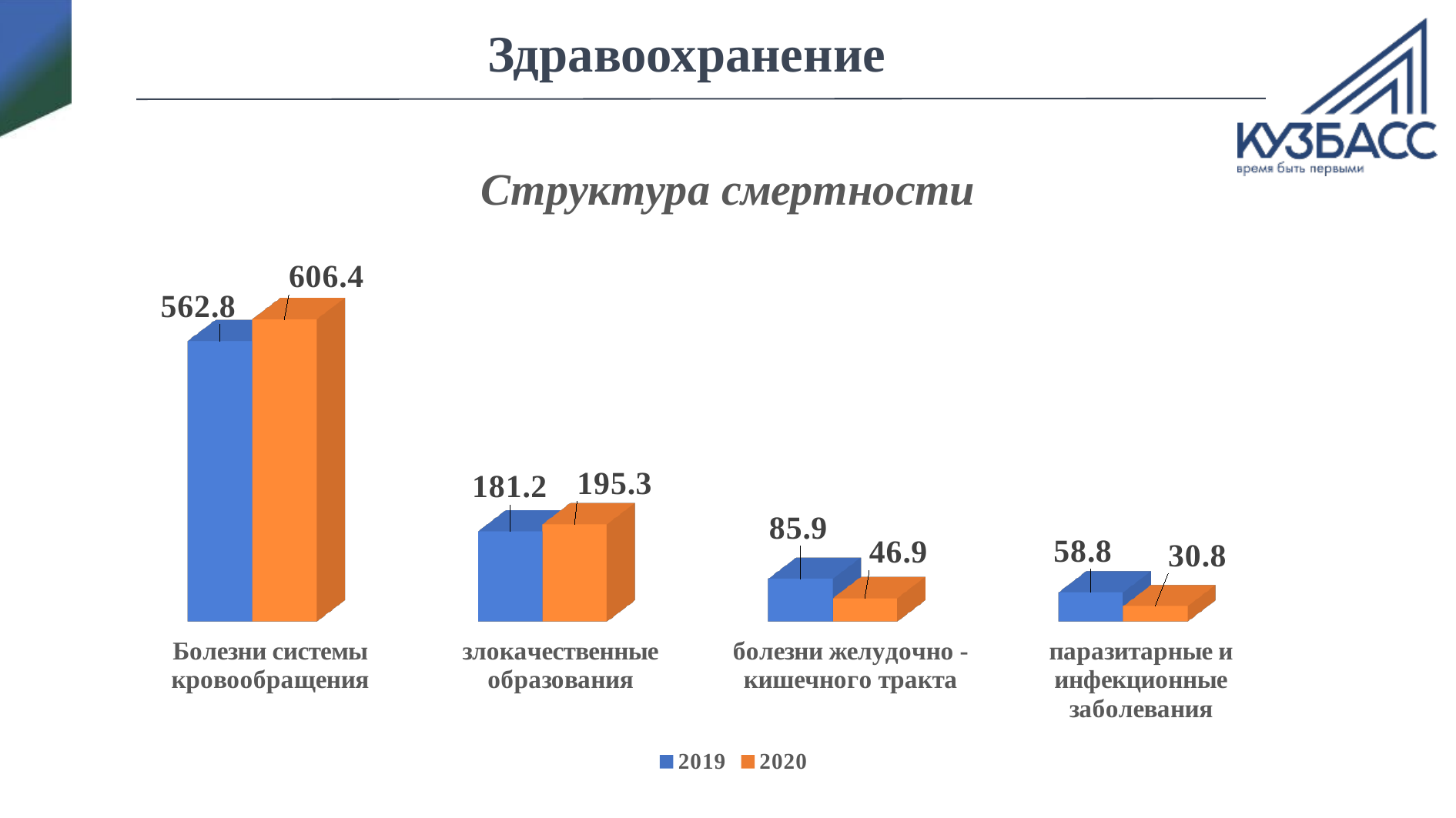
Which category has the highest 2020 value? Болезни системы кровообращения What kind of chart is shown on the slide? Bar chart Which category has the lowest 2019 value? паразитарные и инфекционные заболевания What is the 2020 value for болезни желудочно-кишечного тракта? 46.9 What is the difference between the 2020 and 2019 values for Болезни системы кровообращения? 43.6 What is the difference between the 2019 and 2020 values for болезни желудочно-кишечного тракта? 39 How many categories are shown on the x axis? 4 What is the 2019 value for паразитарные и инфекционные заболевания? 58.8 For паразитарные и инфекционные заболевания, which year has the larger value, 2019 or 2020? 2019 What is the 2019 value for Болезни системы кровообращения? 562.8 How many series does the legend list? 2 What is the 2020 value for злокачественные образования? 195.3